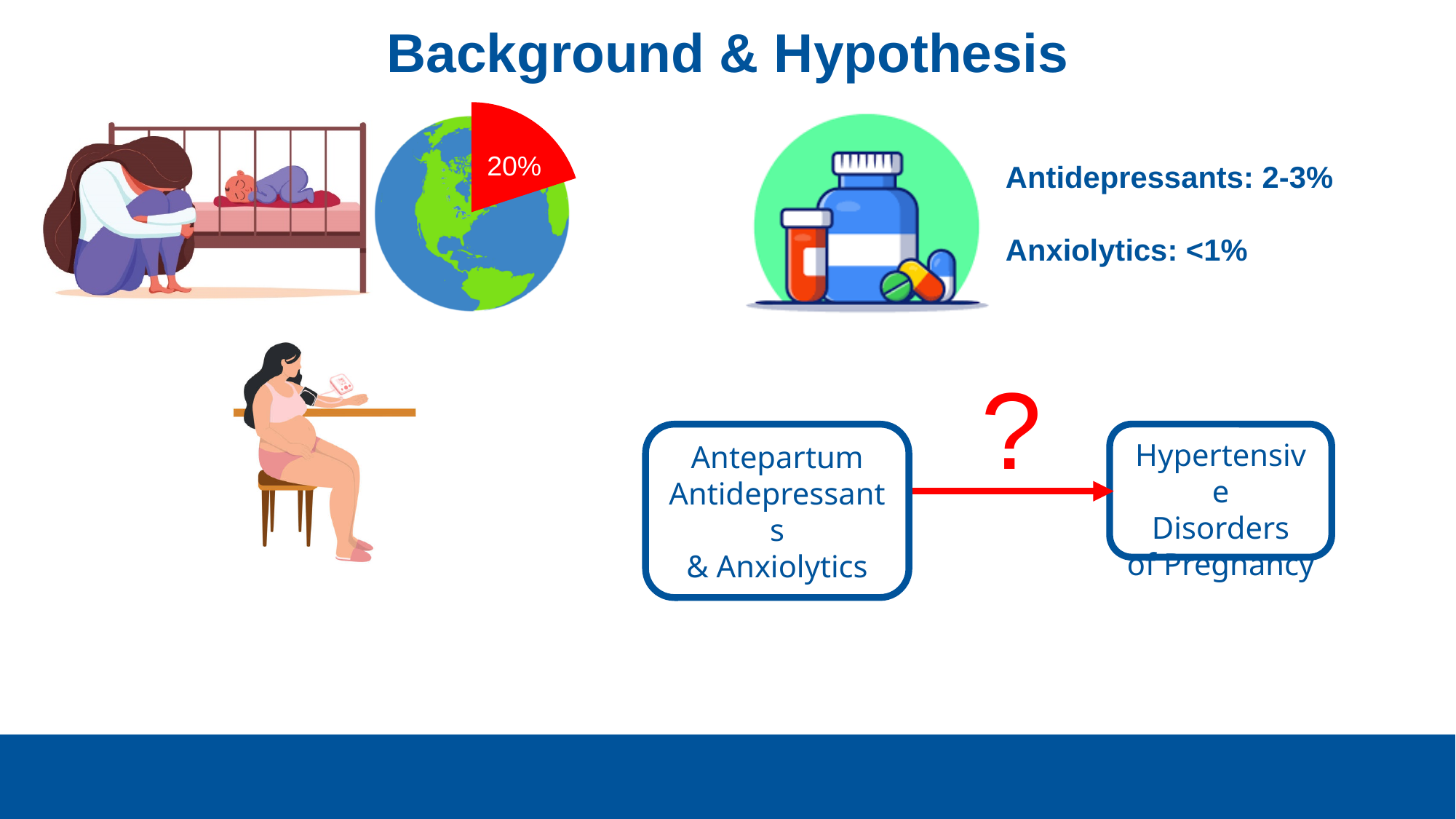
What percentage is printed on the red slice of the pie chart over the globe? 20% What kind of chart is overlaid on the globe image? pie chart Is the red slice of the pie chart over the globe greater or less than 50%? less What colour is the labelled slice of the pie chart over the globe? red How many slices of the pie chart over the globe carry a data label? 1 What share of the pie chart over the globe does the red slice represent? 20%